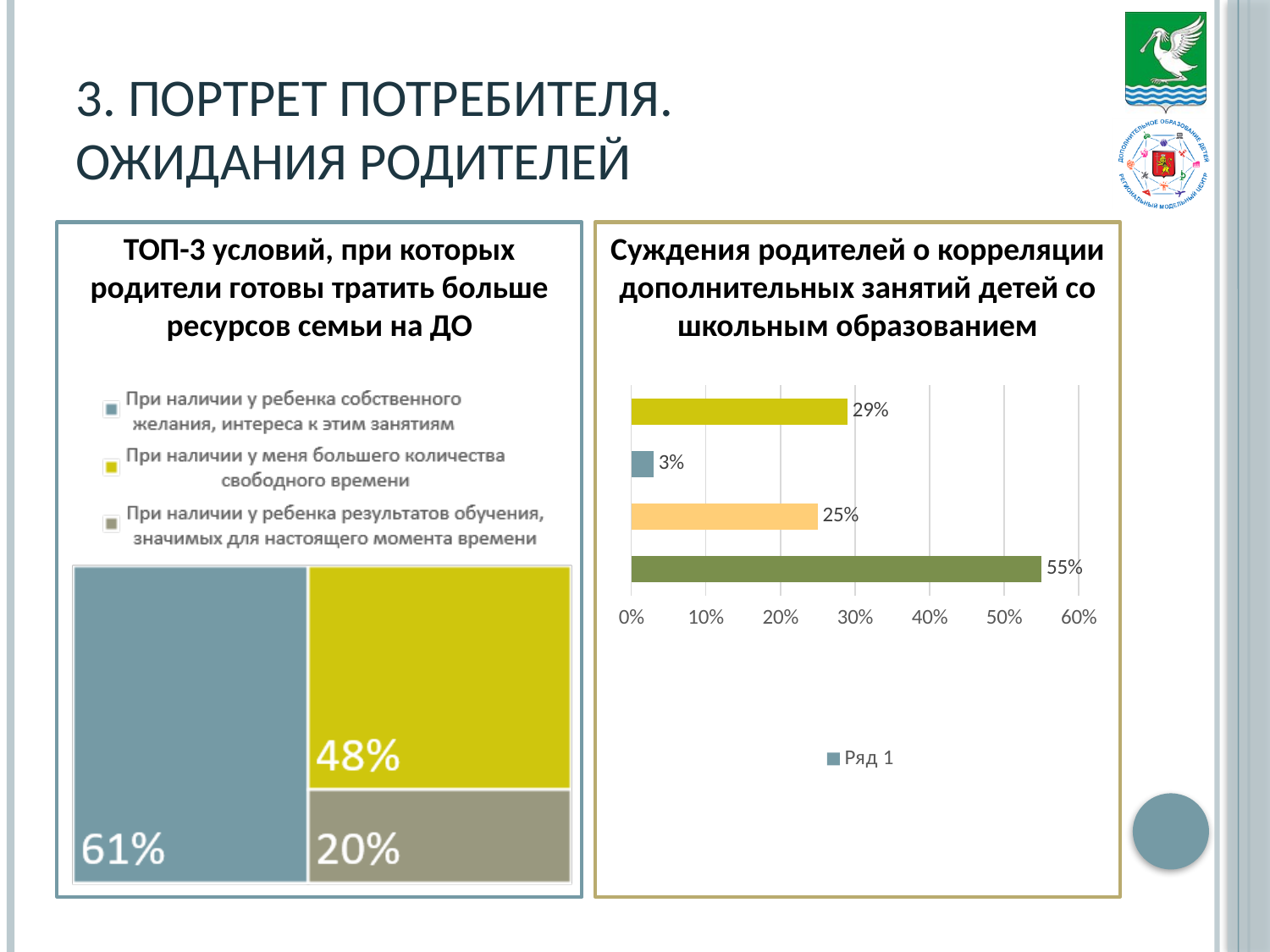
In the right chart 'Суждения родителей о корреляции...', what is the difference between the bottom bar (55%) and the third bar (25%)? 30% In the left chart 'ТОП-3 условий...', what is the difference between the highest value (61%) and the lowest value (20%)? 41% In the right chart 'Суждения родителей о корреляции дополнительных занятий детей со школьным образованием', what is the value of the bottom bar? 55% What kind of chart is the right chart 'Суждения родителей о корреляции...'? Bar chart In the left chart 'ТОП-3 условий...', how many conditions are listed in the legend? 3 In the right chart 'Суждения родителей о корреляции...', how many bars are plotted? 4 In the left chart 'ТОП-3 условий...', what is the value for 'При наличии у ребенка результатов обучения, значимых для настоящего момента времени'? 20% In the left chart 'ТОП-3 условий, при которых родители готовы тратить больше ресурсов семьи на ДО', what is the value for 'При наличии у ребенка собственного желания, интереса к этим занятиям'? 61% In the left chart 'ТОП-3 условий...', which condition has the lowest value? При наличии у ребенка результатов обучения, значимых для настоящего момента времени In the right chart 'Суждения родителей о корреляции...', what is the value of the top bar? 29% In the left chart 'ТОП-3 условий...', what is the value for 'При наличии у меня большего количества свободного времени'? 48% In the right chart 'Суждения родителей о корреляции...', what is the smallest value shown? 3%